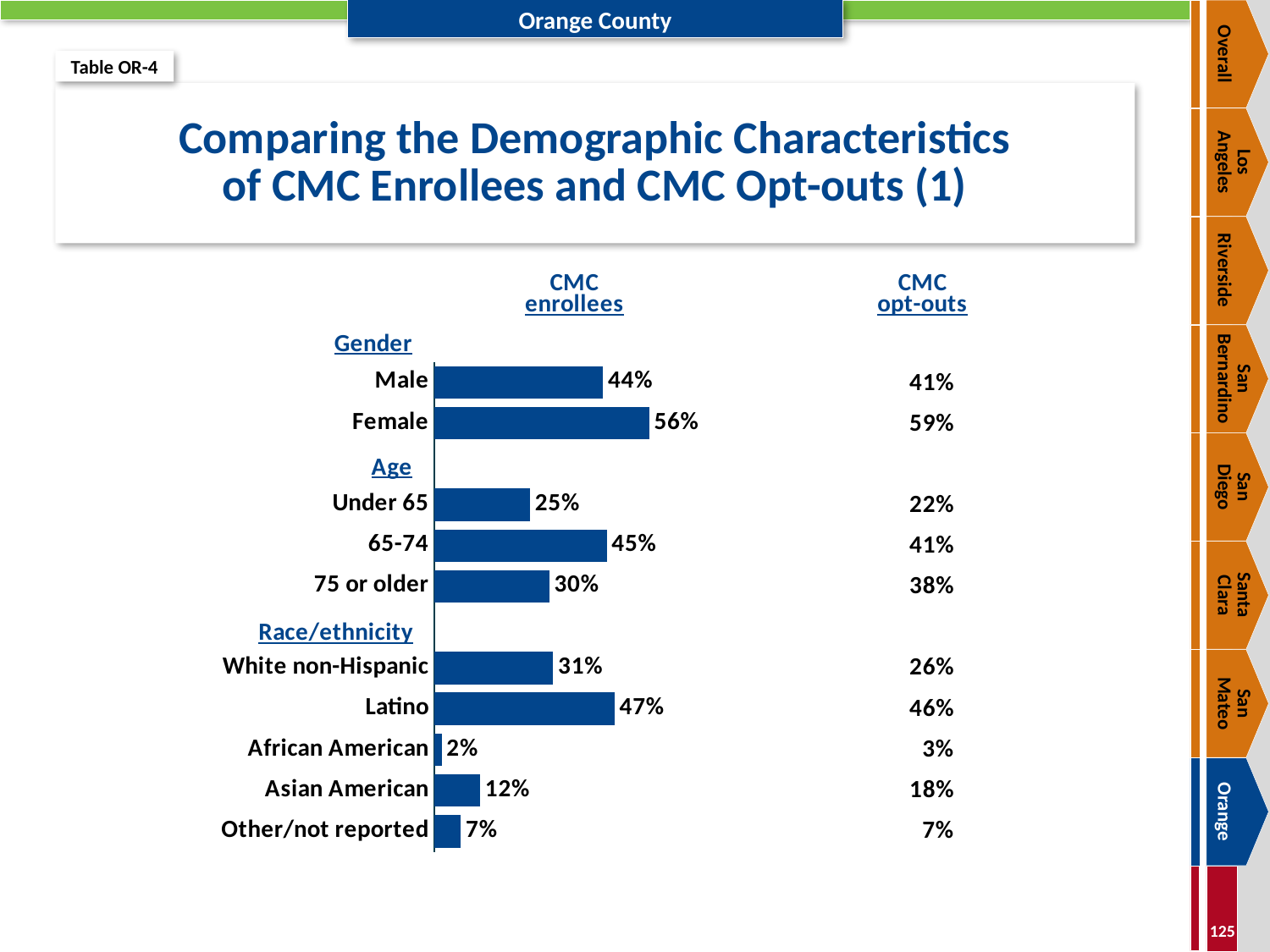
What is the title of the chart on the slide? Comparing the Demographic Characteristics of CMC Enrollees and CMC Opt-outs (1) What is the difference between the Male and Female percentages among CMC enrollees? 12% How many race/ethnicity categories are shown in the chart? 5 What percentage of CMC enrollees are Female? 56% What type of chart is used to show the CMC enrollee percentages? Bar chart What percentage of CMC enrollees are aged 75 or older? 30% Which is larger: the percentage of White non-Hispanic CMC enrollees or White non-Hispanic CMC opt-outs? CMC enrollees What is the difference between the percentage of CMC enrollees and CMC opt-outs who are 75 or older? 8% Which age group has the highest percentage of CMC enrollees? 65-74 What percentage of CMC enrollees are Latino? 47% What percentage of CMC opt-outs are Asian American? 18% Which race/ethnicity category has the lowest percentage of CMC enrollees? African American